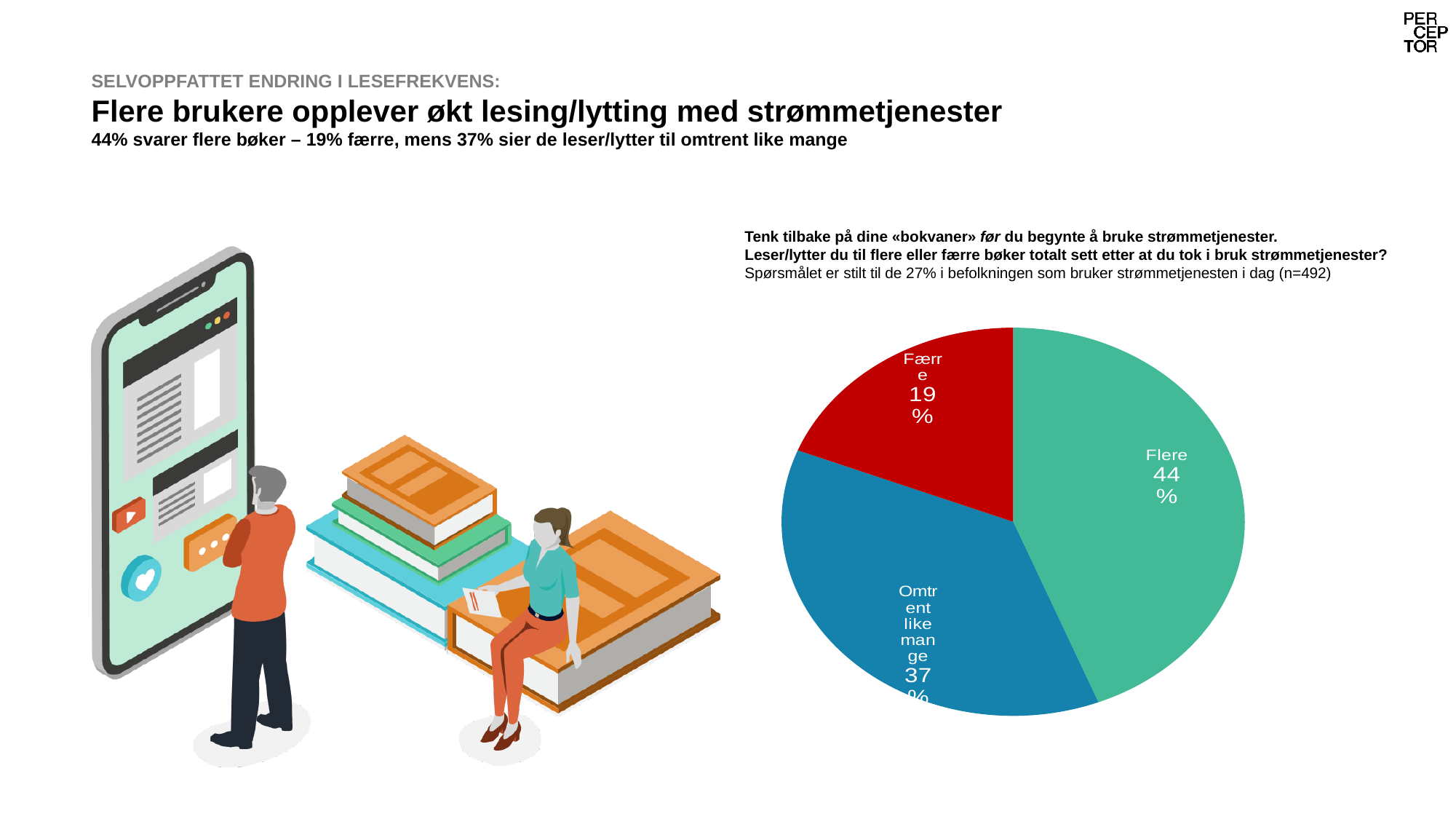
What colour is the "Færre" slice of the pie chart? red Which is larger, the share for "Omtrent like mange" or the share for "Færre"? Omtrent like mange What is the difference in percentage points between "Flere" and "Omtrent like mange"? 7 What percentage of respondents answered "Omtrent like mange"? 37% How many slices does the pie chart have? 3 Which slice of the pie chart is the largest? Flere What is the difference in percentage points between "Flere" and "Færre"? 25 What percentage of respondents answered "Færre"? 19% What percentage of respondents answered "Flere"? 44% Which slice of the pie chart is the smallest? Færre What kind of chart is shown on the slide? pie chart What is the sample size (n) stated for the question shown above the pie chart? 492